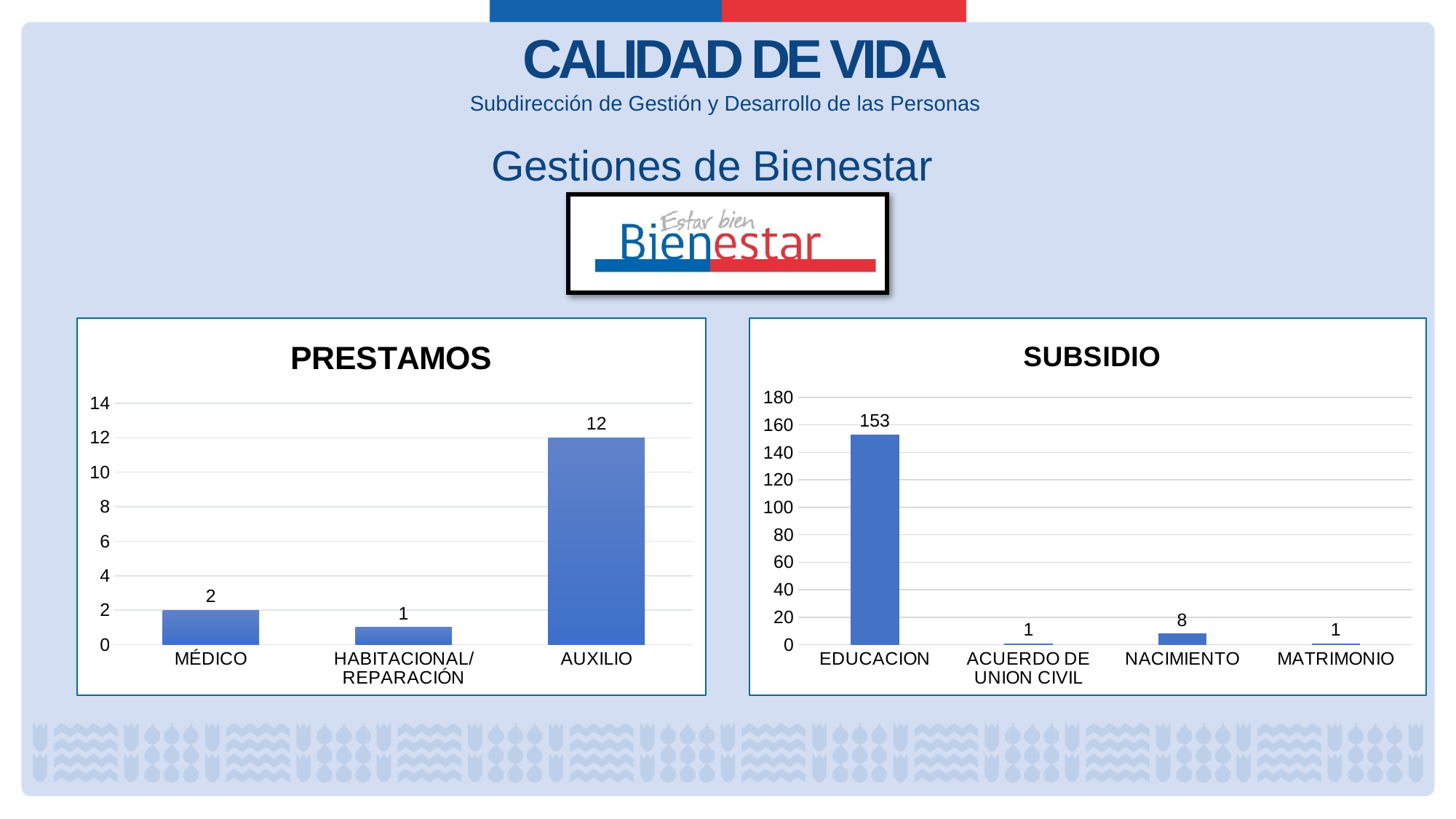
In the SUBSIDIO chart, what is the value for EDUCACION? 153 What type of chart is the SUBSIDIO chart? Bar chart In the SUBSIDIO chart, what is the difference between EDUCACION and NACIMIENTO? 145 In the SUBSIDIO chart, how many categories are shown? 4 In the SUBSIDIO chart, which is larger, NACIMIENTO or MATRIMONIO? NACIMIENTO In the SUBSIDIO chart, which category has the highest value? EDUCACION In the PRESTAMOS chart, which category has the highest value? AUXILIO In the PRESTAMOS chart, what is the value for AUXILIO? 12 In the PRESTAMOS chart, how many categories are shown? 3 In the SUBSIDIO chart, what is the value for NACIMIENTO? 8 In the PRESTAMOS chart, what is the difference between AUXILIO and MÉDICO? 10 In the PRESTAMOS chart, what is the value for HABITACIONAL/REPARACIÓN? 1